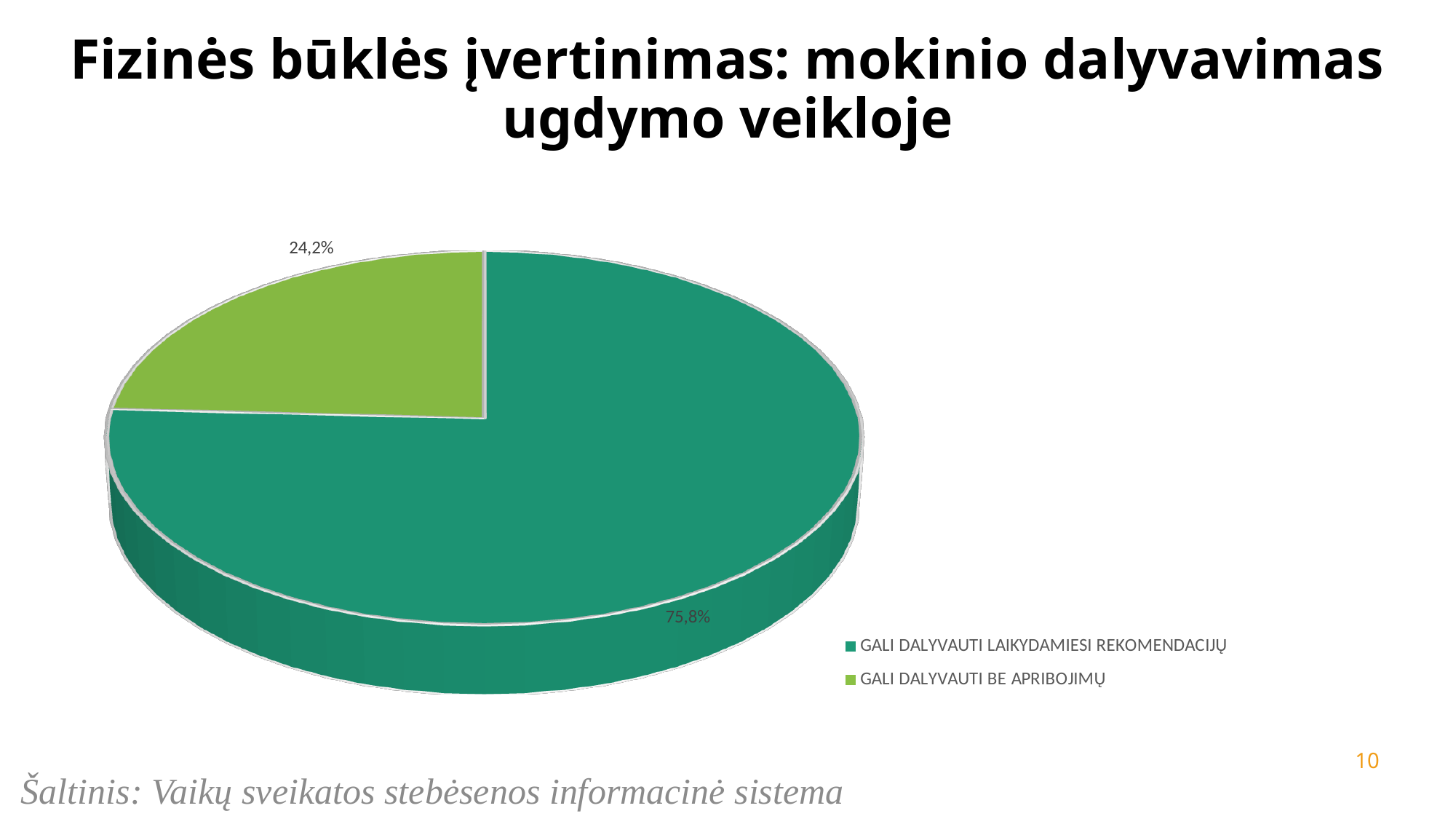
What is the title of the slide containing the pie chart? Fizinės būklės įvertinimas: mokinio dalyvavimas ugdymo veikloje What kind of chart is shown on the slide? pie chart Which category has the smallest slice of the pie? GALI DALYVAUTI BE APRIBOJIMŲ What share of the pie is labelled GALI DALYVAUTI LAIKYDAMIESI REKOMENDACIJŲ? 75,8% What share of the pie is labelled GALI DALYVAUTI BE APRIBOJIMŲ? 24,2% Which category has the largest slice of the pie? GALI DALYVAUTI LAIKYDAMIESI REKOMENDACIJŲ How many entries does the legend list? 2 What colour is the slice for GALI DALYVAUTI BE APRIBOJIMŲ? light green What is the difference in percentage points between the two slices of the pie? 51,6 How many slices does the pie chart have? 2 Which is larger: the slice for GALI DALYVAUTI BE APRIBOJIMŲ or the slice for GALI DALYVAUTI LAIKYDAMIESI REKOMENDACIJŲ? GALI DALYVAUTI LAIKYDAMIESI REKOMENDACIJŲ